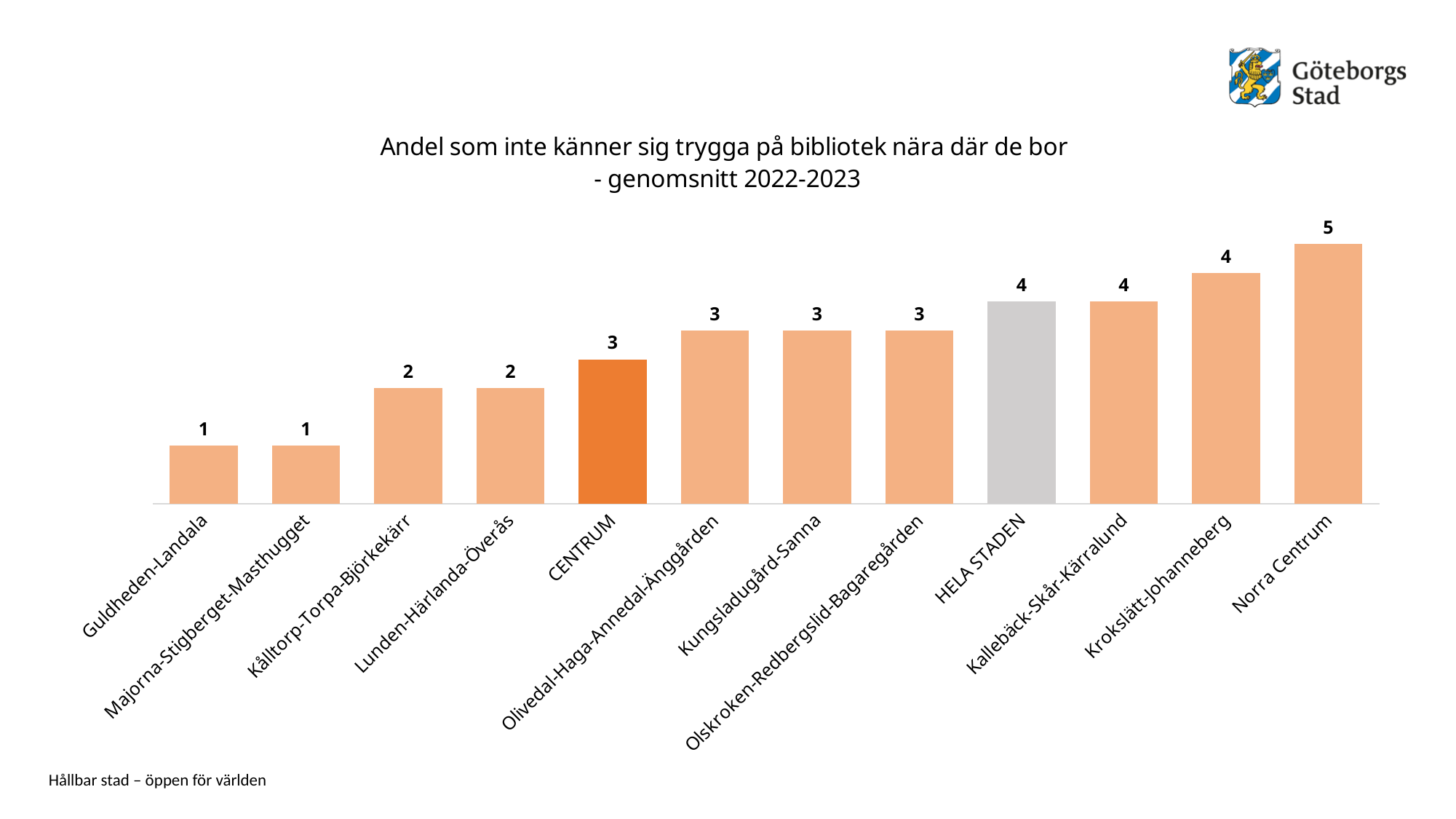
Which bar is shown in grey rather than orange? HELA STADEN Do the values rise or fall from left to right along the x axis? Rise What is the value for CENTRUM? 3 What is the value for Norra Centrum? 5 What is the difference between the values for Norra Centrum and Guldheden-Landala? 4 Which is larger, the value for Krokslätt-Johanneberg or the value for Lunden-Härlanda-Överås? Krokslätt-Johanneberg How many categories are shown in the chart? 12 What is the lowest value shown in the chart? 1 What is the value for Guldheden-Landala? 1 Which category has the highest value? Norra Centrum What kind of chart is shown on the slide? Bar chart What is the value for HELA STADEN? 4